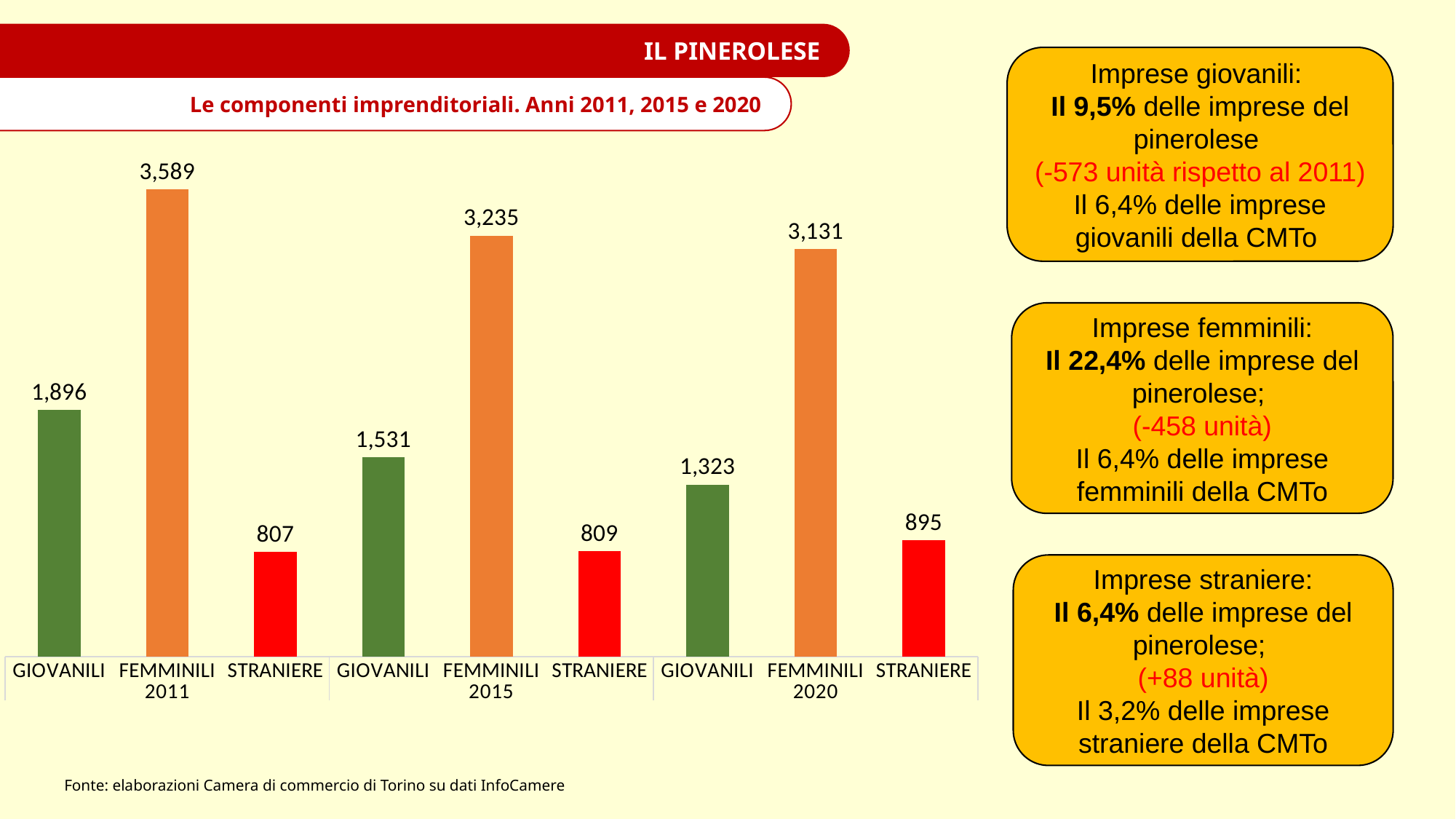
What colour are the STRANIERE bars? Red How many bars are plotted in the chart? 9 What is the value for GIOVANILI in 2020? 1,323 What is the difference between the FEMMINILI values for 2015 and 2020? 104 Which is larger, the STRANIERE value for 2011 or for 2020? 2020 What is the value for FEMMINILI in 2011? 3,589 Which bar has the highest value in the chart? FEMMINILI 2011 What is the value for STRANIERE in 2015? 809 Do the GIOVANILI values rise or fall from 2011 to 2020? Fall Which bar has the lowest value in the chart? STRANIERE 2011 What is the difference between the GIOVANILI values for 2011 and 2020? 573 What kind of chart is shown on the slide? Bar chart